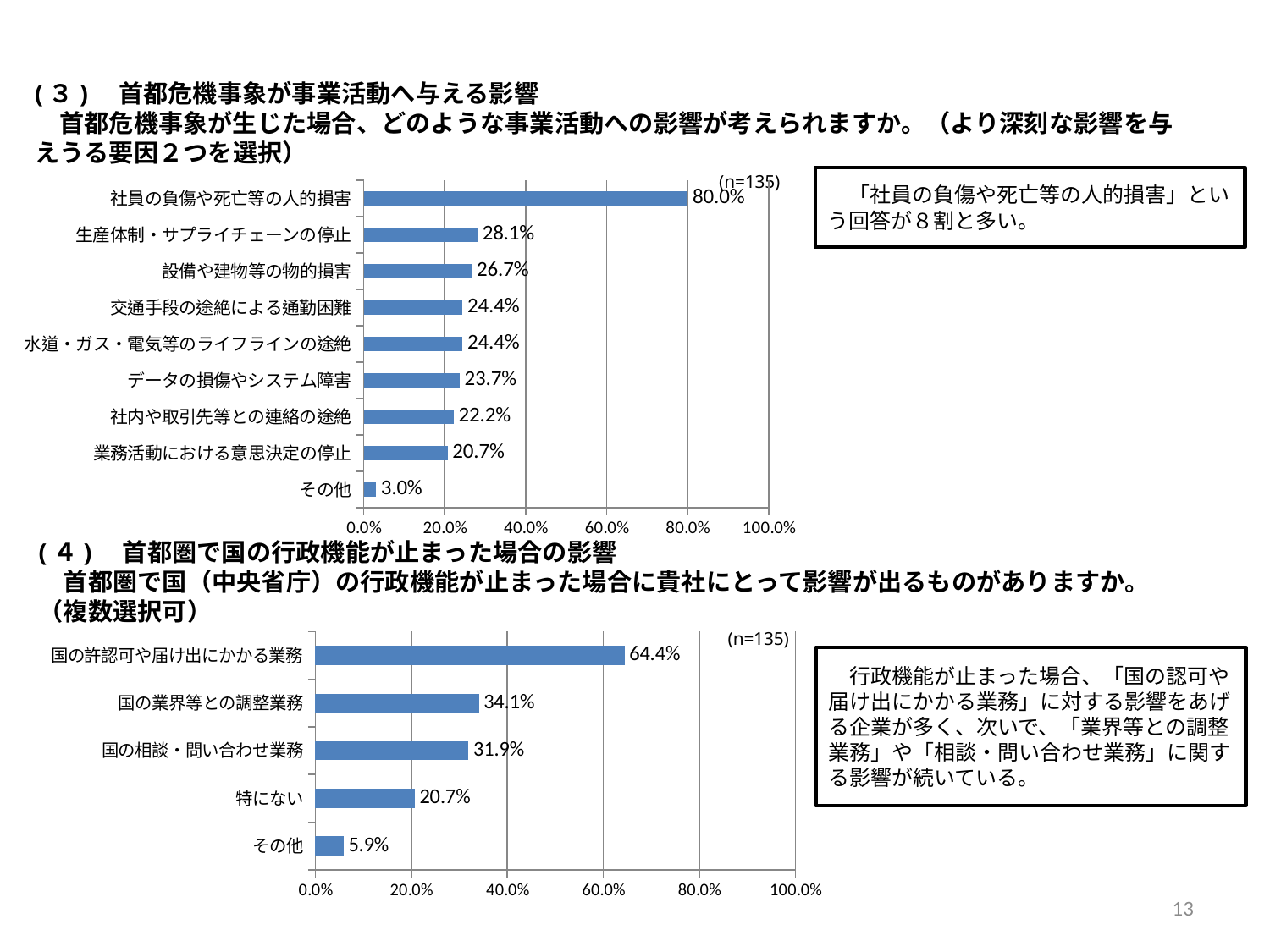
In the top chart (首都危機事象が事業活動へ与える影響), how many categories are plotted? 9 In the top chart (首都危機事象が事業活動へ与える影響), which category has the lowest value? その他 In the top chart (首都危機事象が事業活動へ与える影響), which is larger: 設備や建物等の物的損害 or 業務活動における意思決定の停止? 設備や建物等の物的損害 In the top chart (首都危機事象が事業活動へ与える影響), what is the value for 社員の負傷や死亡等の人的損害? 80.0% What kind of chart is the bottom chart (首都圏で国の行政機能が止まった場合の影響)? Bar chart In the bottom chart (首都圏で国の行政機能が止まった場合の影響), what is the value for 特にない? 20.7% In the top chart (首都危機事象が事業活動へ与える影響), what is the difference between 社員の負傷や死亡等の人的損害 and 生産体制・サプライチェーンの停止? 51.9% In the top chart (首都危機事象が事業活動へ与える影響), what is the value for 生産体制・サプライチェーンの停止? 28.1% In the bottom chart (首都圏で国の行政機能が止まった場合の影響), what is the value for 国の許認可や届け出にかかる業務? 64.4% In the bottom chart (首都圏で国の行政機能が止まった場合の影響), what is the difference between 国の業界等との調整業務 and 国の相談・問い合わせ業務? 2.2% In the bottom chart (首都圏で国の行政機能が止まった場合の影響), which category has the highest value? 国の許認可や届け出にかかる業務 In the bottom chart (首都圏で国の行政機能が止まった場合の影響), how many categories are plotted? 5